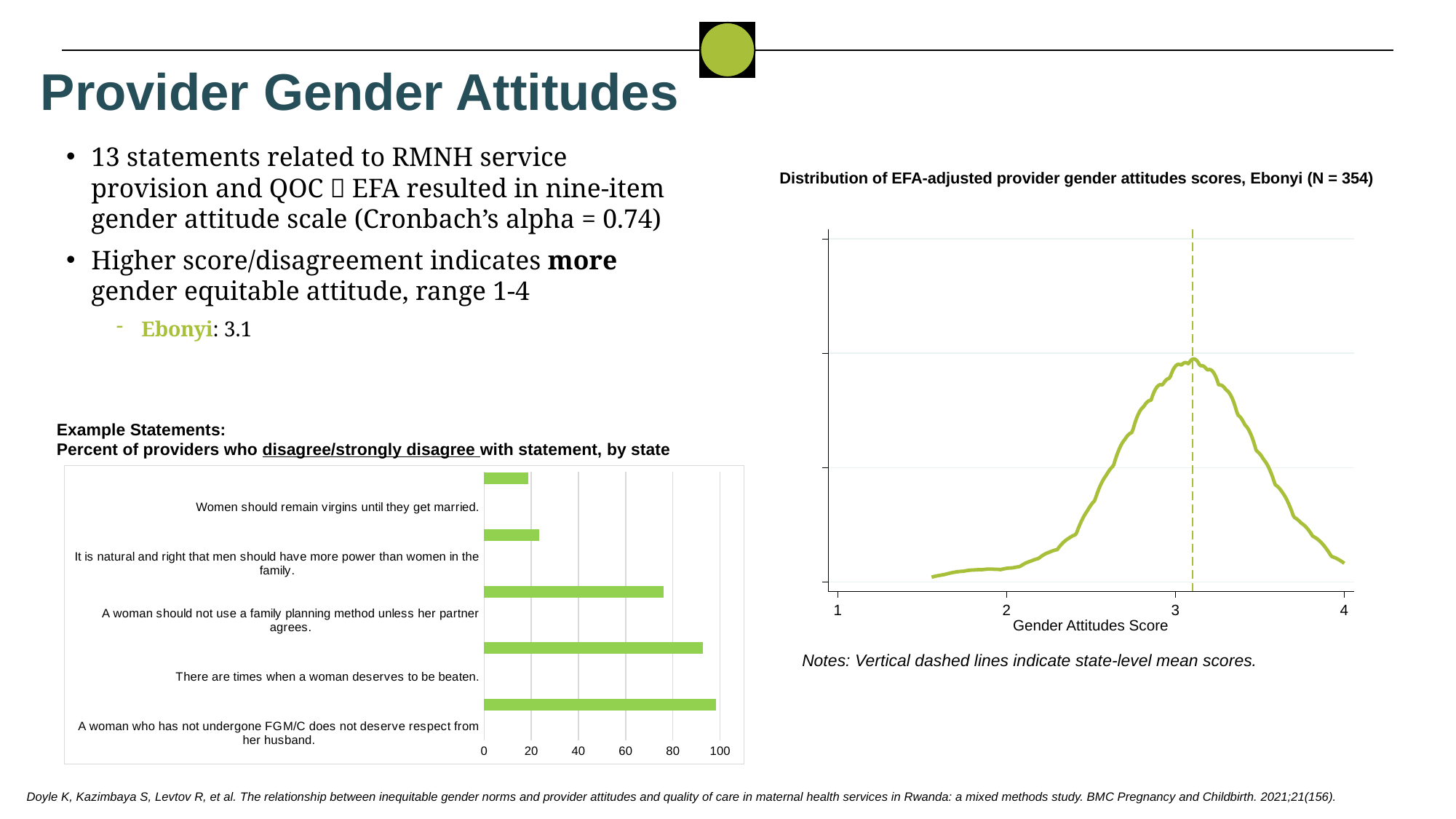
In the bottom-left bar chart, which statement has the highest percent of providers who disagree/strongly disagree? A woman who has not undergone FGM/C does not deserve respect from her husband. What is the x-axis label of the right-hand chart showing the distribution of gender attitudes scores? Gender Attitudes Score What kind of chart is the bottom-left chart titled 'Percent of providers who disagree/strongly disagree with statement, by state'? bar chart How many statements are plotted in the bottom-left bar chart? 5 In the right-hand distribution chart, what is the sample size (N) given in the title for Ebonyi? 354 What is the highest tick value shown on the horizontal axis of the bottom-left bar chart? 100 In the right-hand distribution chart, is the peak of the curve located at a Gender Attitudes Score greater or less than 2? greater In the bottom-left bar chart, which statement has the lowest percent of providers who disagree/strongly disagree? Women should remain virgins until they get married. In the bottom-left bar chart, is the value for 'It is natural and right that men should have more power than women in the family.' greater or less than 40? less In the bottom-left bar chart, which has a larger value: 'There are times when a woman deserves to be beaten.' or 'A woman should not use a family planning method unless her partner agrees.'? There are times when a woman deserves to be beaten. In the bottom-left bar chart, is the value for 'A woman should not use a family planning method unless her partner agrees.' greater or less than 60? greater